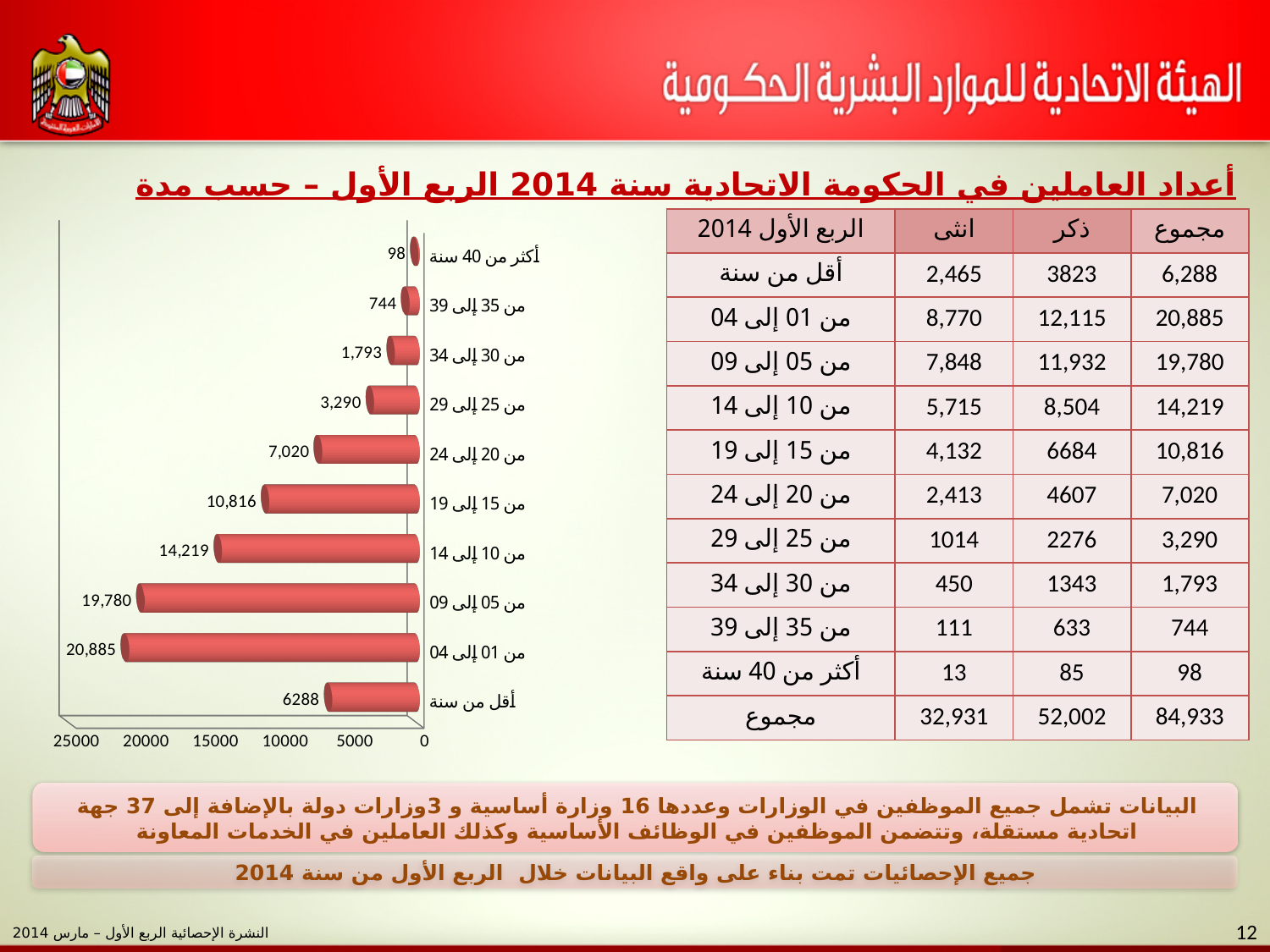
What value does the bar for "من 15 إلى 19" show? 10,816 Which category has the lowest value in the chart? أكثر من 40 سنة What type of chart is shown on the slide? bar chart What is the maximum value shown on the chart's value axis? 25000 What value does the bar for "أكثر من 40 سنة" show? 98 Is the value for "من 25 إلى 29" greater or less than 5000? less Which category has the highest value in the chart? من 01 إلى 04 What value does the bar for "من 01 إلى 04" show? 20,885 What value does the bar for "أقل من سنة" show? 6288 What is the difference between the values for "من 01 إلى 04" and "من 05 إلى 09"? 1,105 How many categories (bars) are shown in the chart? 10 Which is larger, the value for "من 10 إلى 14" or the value for "من 20 إلى 24"? من 10 إلى 14